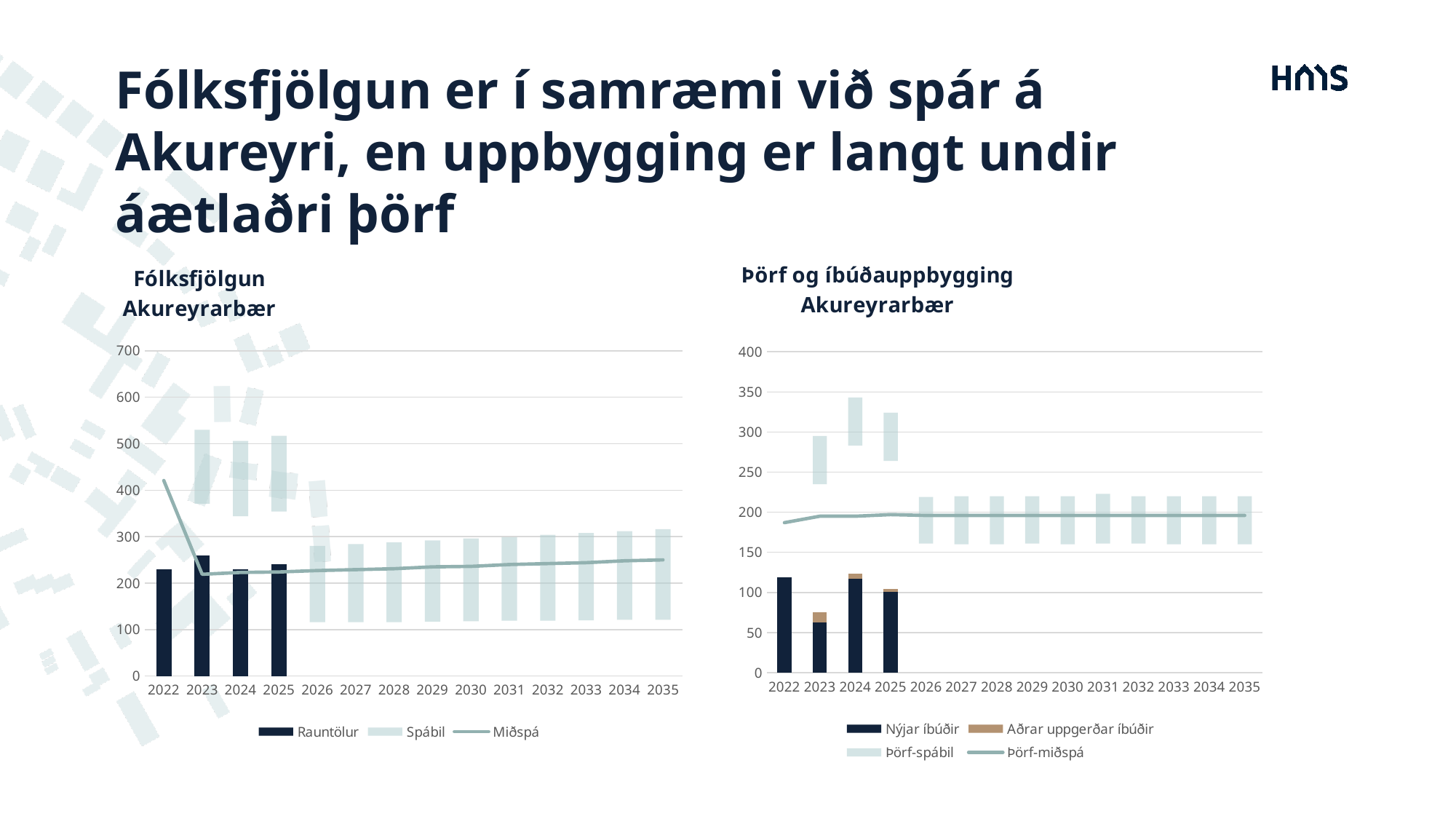
In the right chart 'Þörf og íbúðauppbygging Akureyrarbær', is the Þörf-miðspá value for 2030 greater or less than 150? greater In the right chart 'Þörf og íbúðauppbygging Akureyrarbær', is the Nýjar íbúðir value for 2023 greater or less than 100? less In the left chart 'Fólksfjölgun Akureyrarbær', is the Rauntölur value for 2023 greater or less than 200? greater In the right chart 'Þörf og íbúðauppbygging Akureyrarbær', which year has the lowest Nýjar íbúðir bar? 2023 In the left chart 'Fólksfjölgun Akureyrarbær', how many years are shown on the x axis? 14 In the left chart 'Fólksfjölgun Akureyrarbær', how many series does the legend list? 3 In the left chart 'Fólksfjölgun Akureyrarbær', which year has the highest Rauntölur bar? 2023 In the right chart 'Þörf og íbúðauppbygging Akureyrarbær', which is larger, the Nýjar íbúðir value for 2022 or for 2023? 2022 What kind of chart is the left chart titled 'Fólksfjölgun Akureyrarbær'? bar chart with a line In the right chart 'Þörf og íbúðauppbygging Akureyrarbær', how many series does the legend list? 4